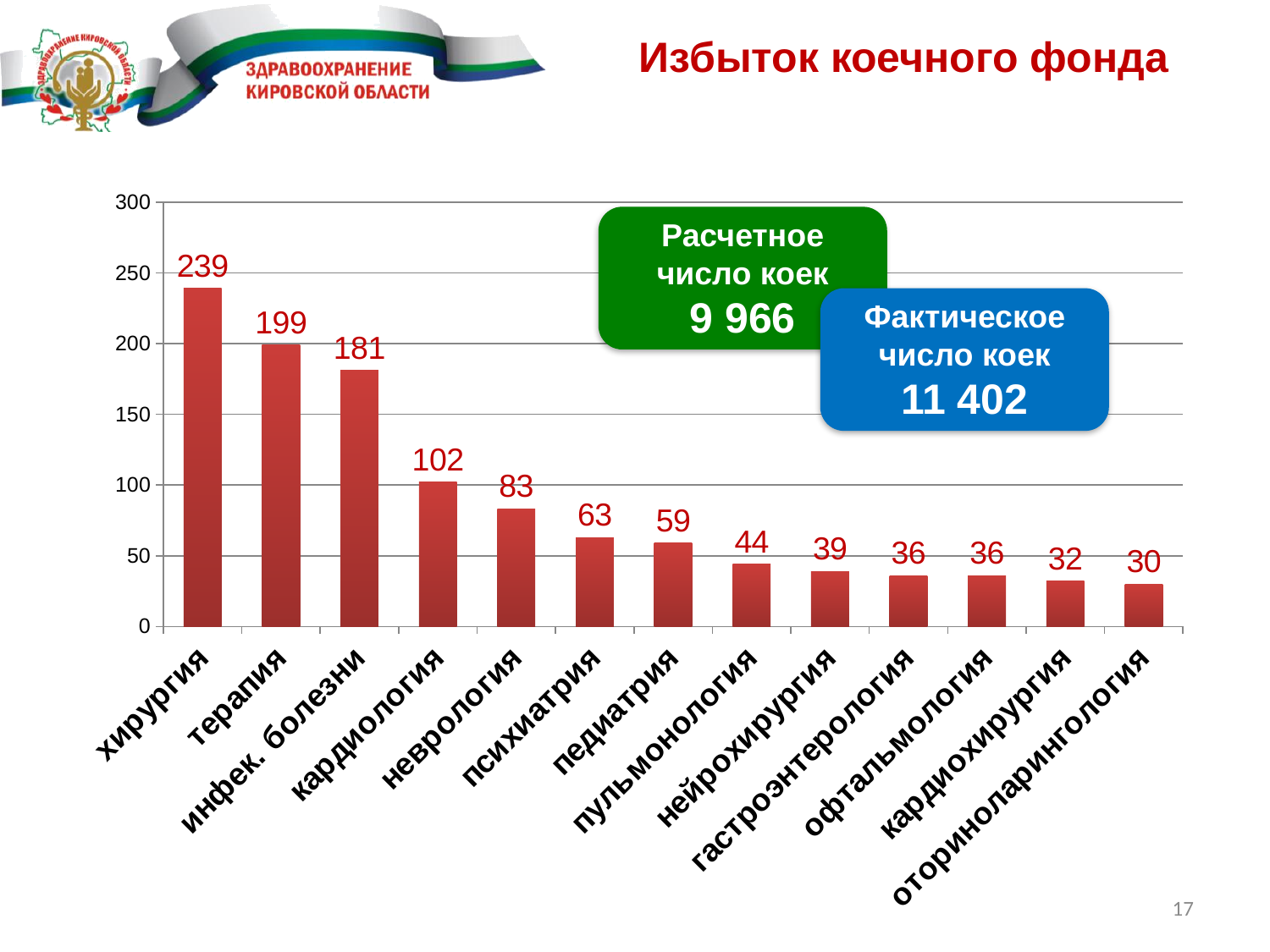
Is the value for инфек. болезни greater or less than 150? greater What is the value for хирургия? 239 Which category has the lowest value? оториноларингология How many categories are shown on the x axis? 13 What is the title of the slide? Избыток коечного фонда What is the value for пульмонология? 44 What kind of chart is shown on the slide? bar chart Which category has the highest value? хирургия Do the values rise or fall from left to right along the x axis? fall What is the difference between the values for хирургия and терапия? 40 What is the value for кардиология? 102 Which is larger, the value for неврология or the value for психиатрия? неврология